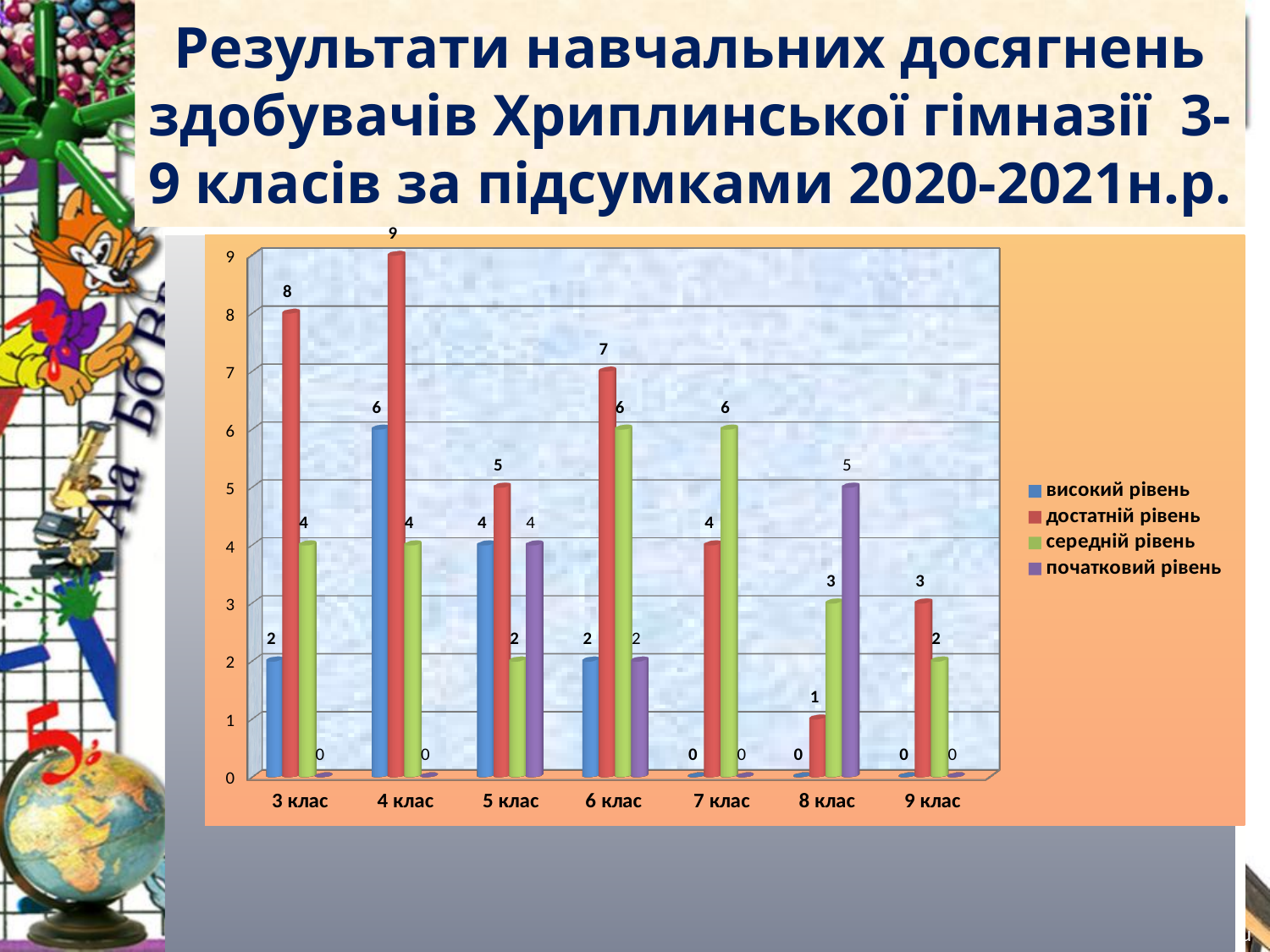
Which is larger for 6 клас: достатній рівень or середній рівень? достатній рівень What is the value of достатній рівень for 4 клас? 9 What is the value of середній рівень for 7 клас? 6 What is the value of початковий рівень for 8 клас? 5 What kind of chart is shown on the slide? bar chart Which class has the lowest value for достатній рівень? 8 клас Which class has the highest value for достатній рівень? 4 клас What is the value of високий рівень for 5 клас? 4 What is the difference between достатній рівень and високий рівень for 3 клас? 6 How many series does the legend list? 4 What is the total of all four levels for 5 клас? 15 How many classes are shown on the x axis? 7